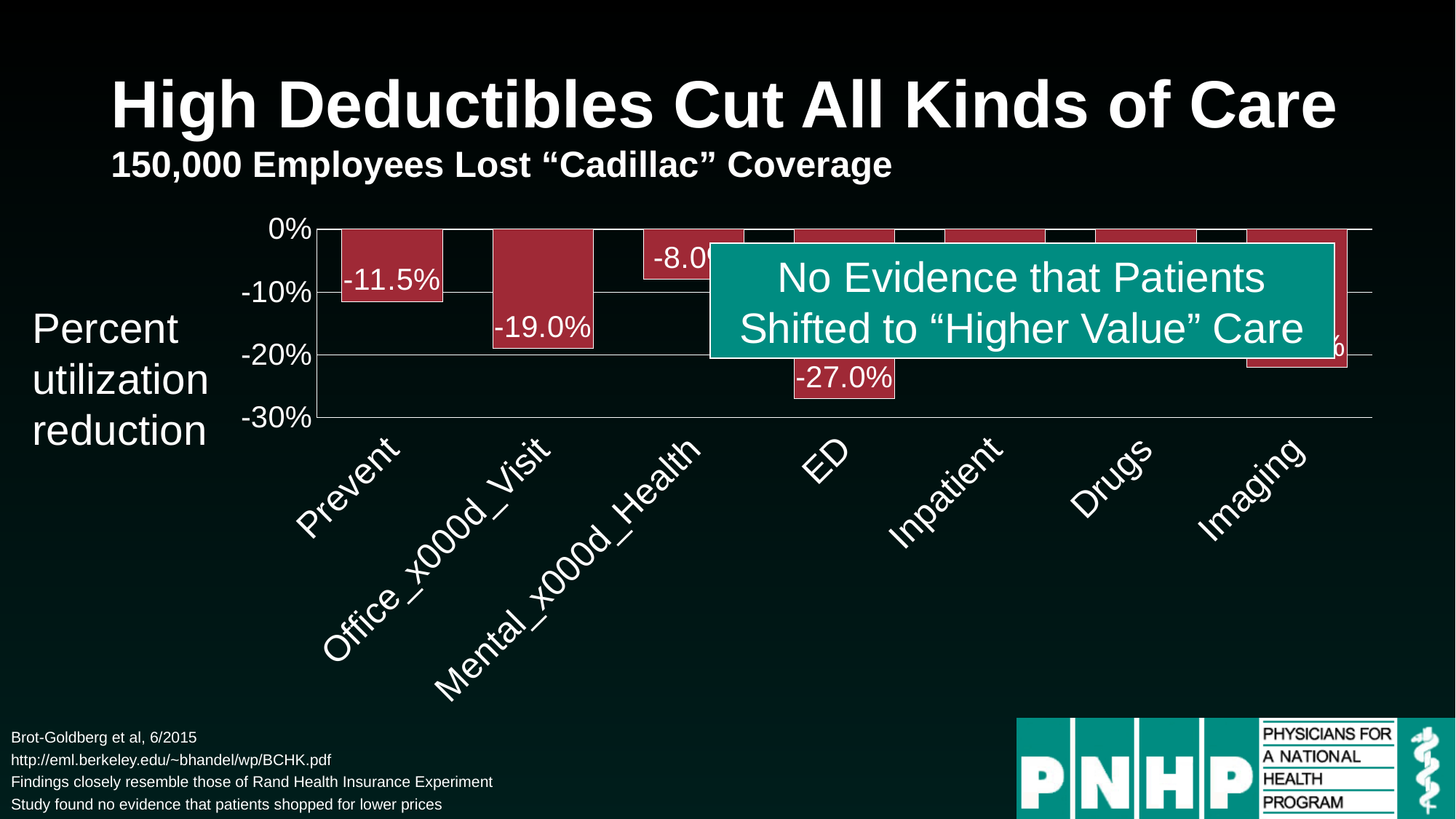
What kind of chart is shown on the slide? Bar chart What is the difference in percentage points between the reductions for ED and Prevent? 15.5 percentage points What is the percent utilization reduction for ED? -27.0% What is the percent utilization reduction for Prevent? -11.5% What is the label on the vertical axis of the chart? Percent utilization reduction Which has the larger utilization reduction, Prevent or Office_x000d_Visit? Office_x000d_Visit Which has the larger utilization reduction, ED or Office_x000d_Visit? ED How many categories are shown on the x axis of the chart? 7 What is the lowest tick value shown on the vertical axis? -30% What is the difference in percentage points between the reductions for Office_x000d_Visit and Prevent? 7.5 percentage points Which category shows the largest utilization reduction? ED What is the percent utilization reduction for Office_x000d_Visit? -19.0%